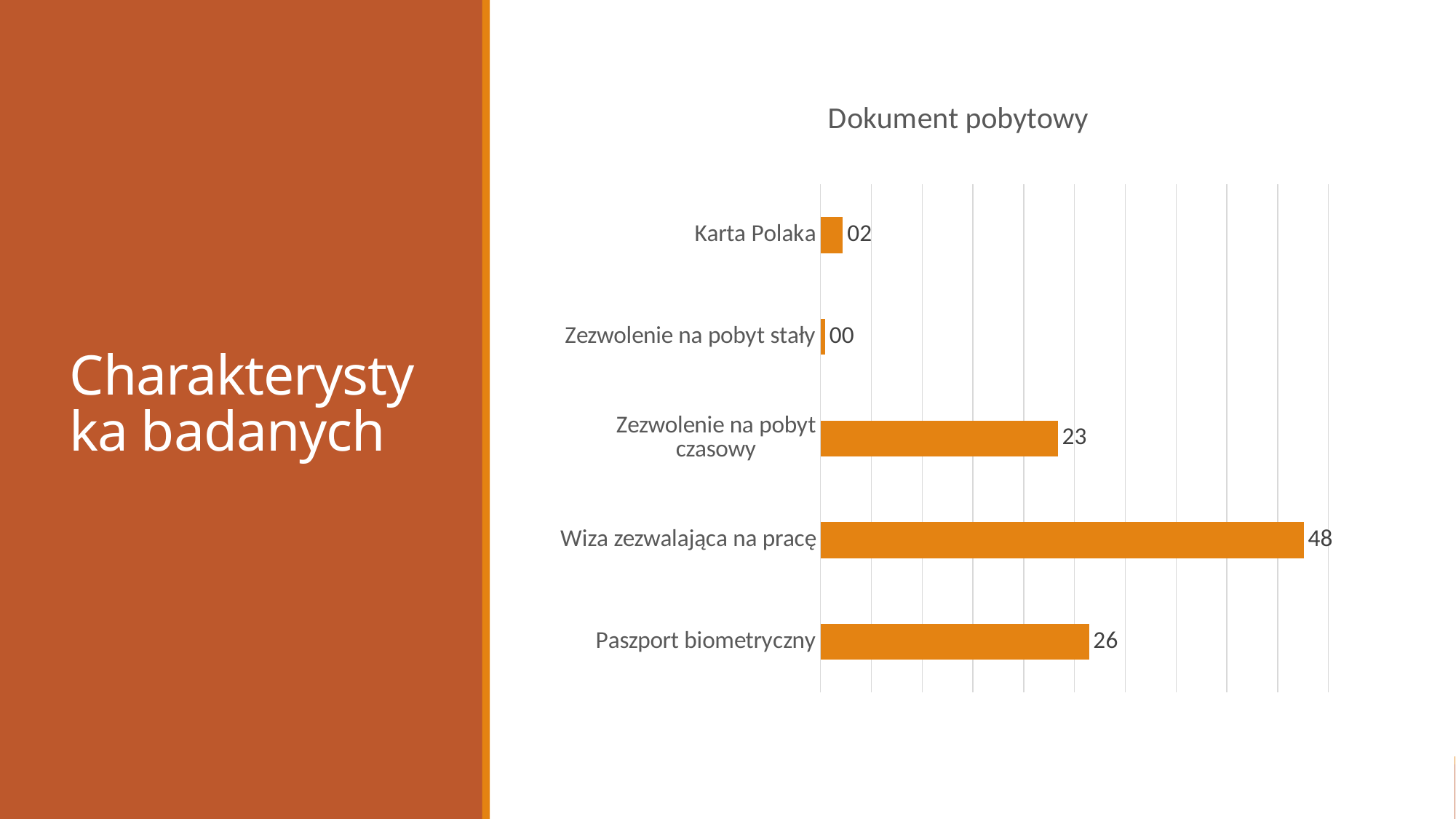
What is the value for Wiza zezwalająca na pracę? 48 Which category has the highest value? Wiza zezwalająca na pracę What is the value for Zezwolenie na pobyt stały? 00 What is the value for Karta Polaka? 02 How many categories are shown in the chart? 5 What is the value for Zezwolenie na pobyt czasowy? 23 Which category has the lowest value? Zezwolenie na pobyt stały What is the difference between the values for Wiza zezwalająca na pracę and Paszport biometryczny? 22 What is the title of the chart? Dokument pobytowy What is the value for Paszport biometryczny? 26 Which is larger, the value for Paszport biometryczny or the value for Zezwolenie na pobyt czasowy? Paszport biometryczny What kind of chart is shown on the slide? Bar chart